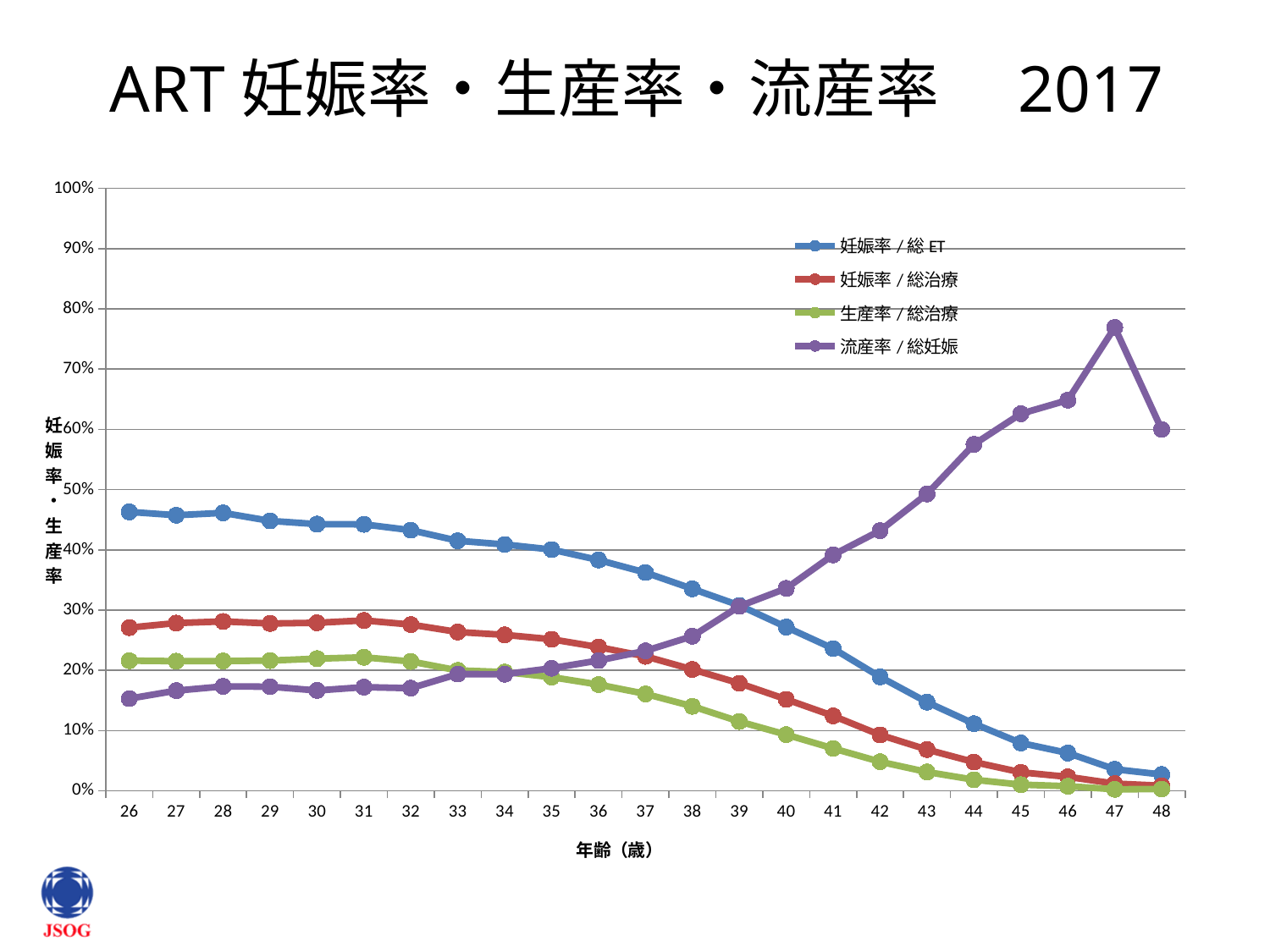
What kind of chart is shown on the slide? line chart How many age categories are plotted along the x axis? 23 What is the title of the chart on the slide? ART 妊娠率・生産率・流産率 2017 Which series is drawn in purple according to the legend? 流産率 / 総妊娠 At age 40, which is larger: 妊娠率 / 総 ET or 流産率 / 総妊娠? 流産率 / 総妊娠 At which age is the 妊娠率 / 総 ET series lowest? 48 Is the value for 流産率 / 総妊娠 at age 47 greater or less than 70%? greater At which age does the 流産率 / 総妊娠 series reach its highest value? 47 Does the 流産率 / 総妊娠 series generally rise or fall as age increases from 26 to 47? rise Does the 妊娠率 / 総 ET series rise or fall as age increases from 26 to 48? fall Is the value for 妊娠率 / 総 ET at age 26 greater or less than 40%? greater How many series does the legend list? 4